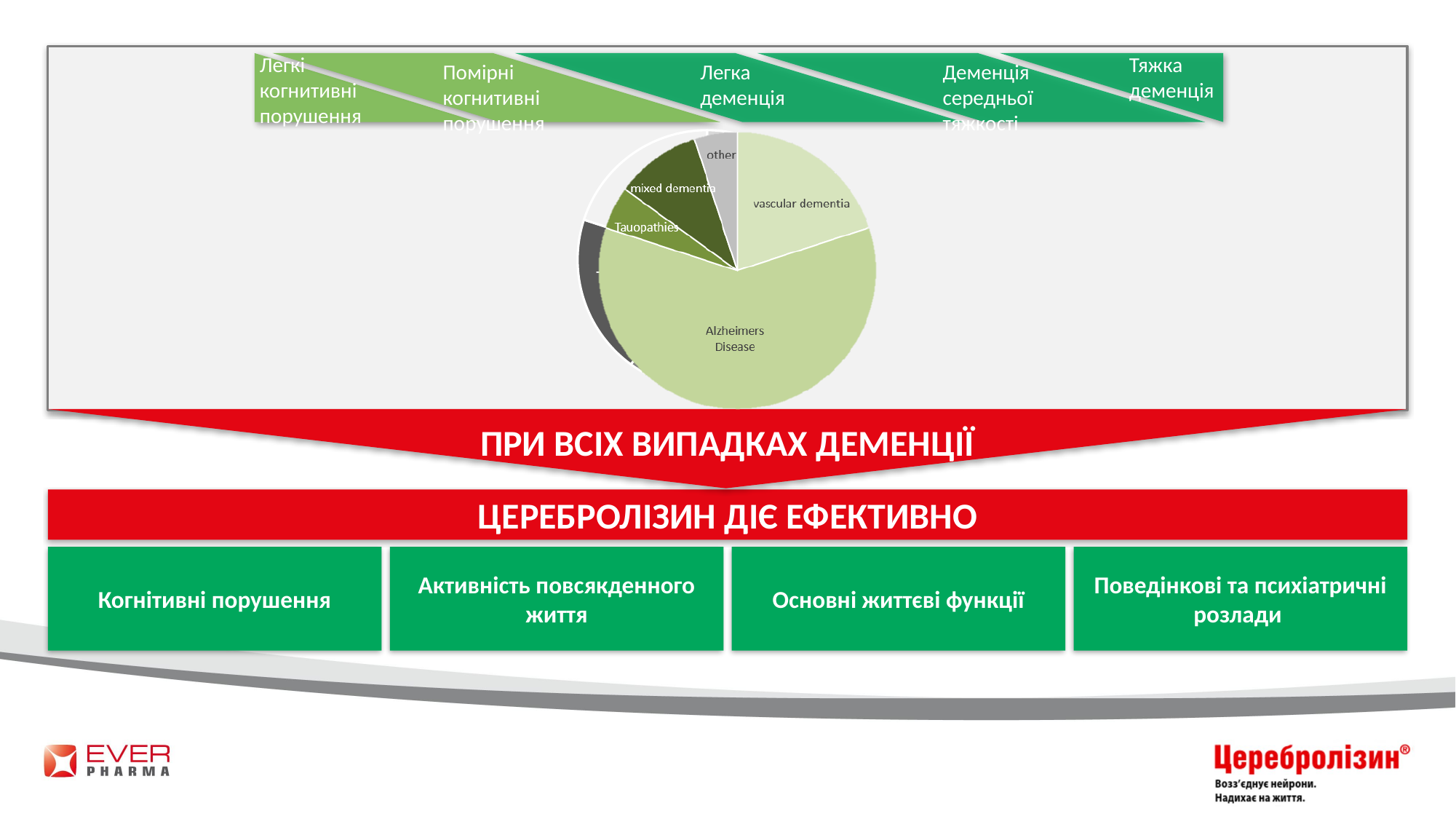
How many labelled slices does the pie chart have? 5 What colour is the slice labelled 'other' in the pie chart? grey Which slice is larger, Alzheimers Disease or mixed dementia? Alzheimers Disease Which slice of the pie chart is the largest? Alzheimers Disease Which slice is larger, vascular dementia or Tauopathies? vascular dementia Which slice is larger, Alzheimers Disease or vascular dementia? Alzheimers Disease Does the pie chart have a legend? No What kind of chart is shown on the slide? pie chart